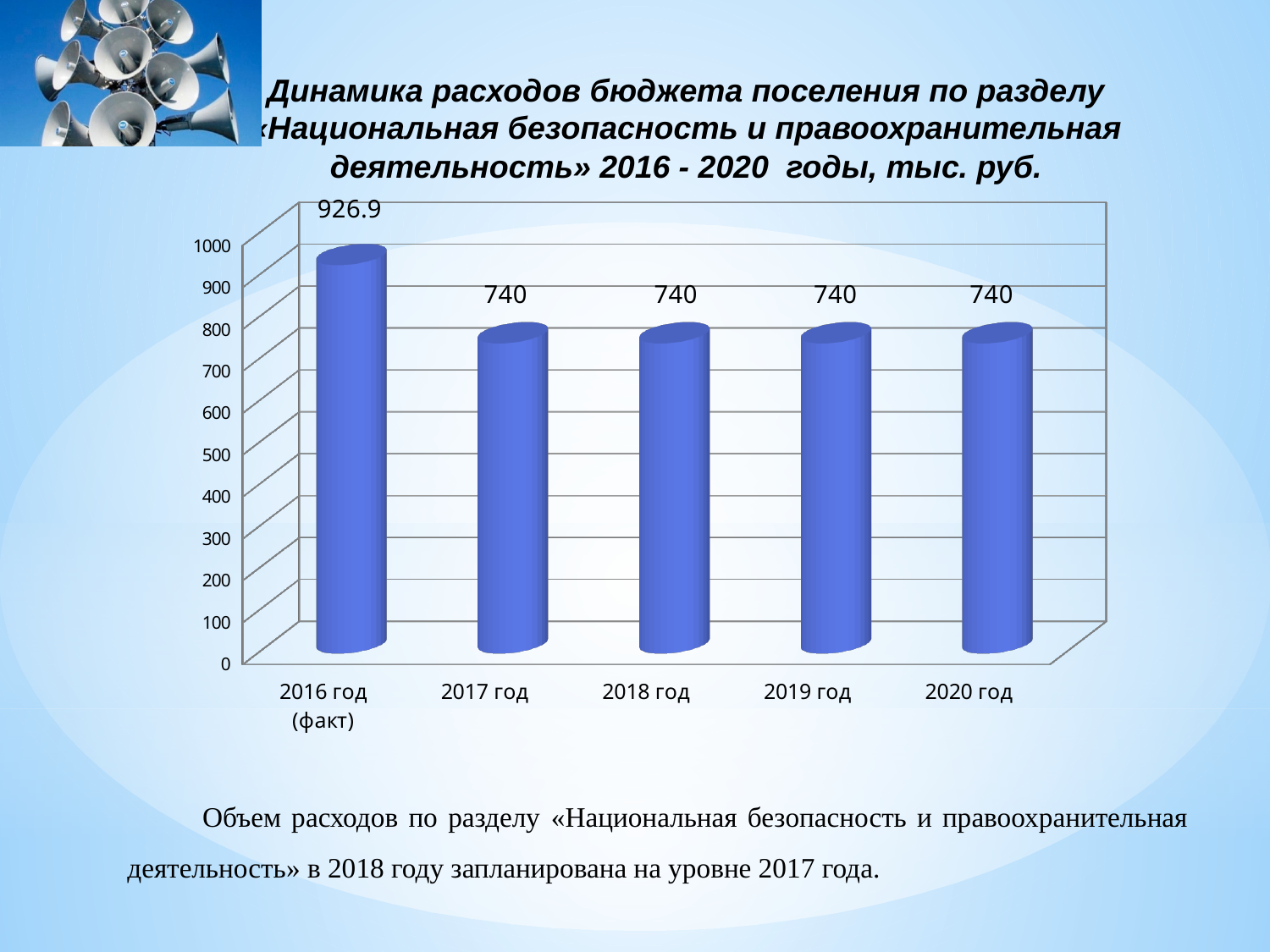
Which year has the highest value? 2016 год (факт) What is the value for 2016 год (факт)? 926.9 Do the values rise or fall from 2016 год (факт) to 2017 год? fall What kind of chart is shown on the slide? bar chart What is the difference between the values for 2016 год (факт) and 2017 год? 186.9 Is the value for 2017 год greater or less than 800? less Is the value for 2016 год (факт) greater or less than 900? greater In what units are the values on the chart expressed, according to the title? тыс. руб. How many years are shown on the x axis? 5 Which is larger, the value for 2016 год (факт) or the value for 2019 год? 2016 год (факт) What is the value for 2020 год? 740 What is the value for 2018 год? 740